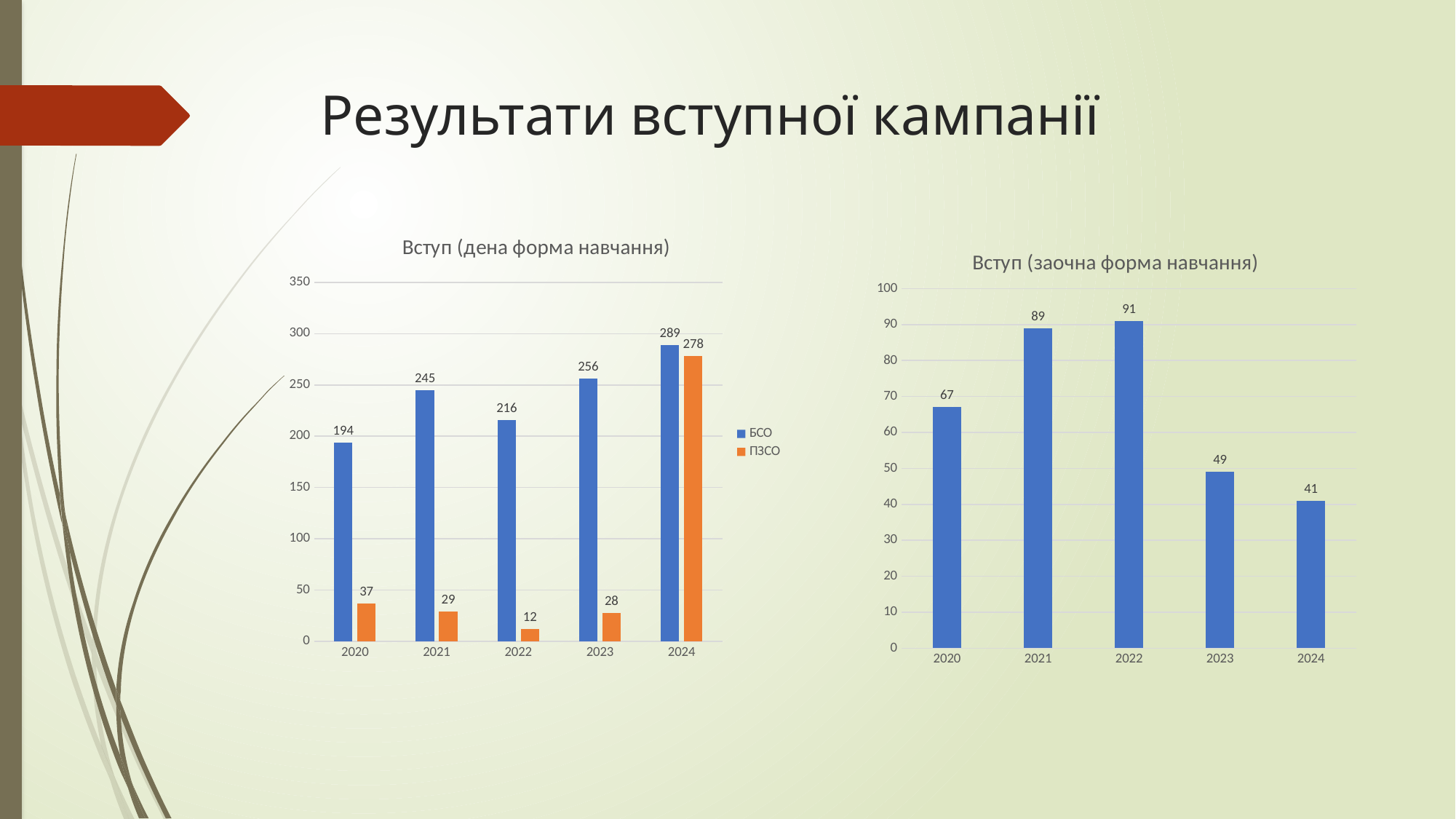
In the chart titled 'Вступ (заочна форма навчання)', what is the value for 2020? 67 In the chart titled 'Вступ (дена форма навчання)', how many series does the legend list? 2 In the chart titled 'Вступ (дена форма навчання)', which year has the lowest ПЗСО value? 2022 In the chart titled 'Вступ (дена форма навчання)', what is the value for БСО in 2021? 245 In the chart titled 'Вступ (заочна форма навчання)', which year has the highest value? 2022 In the chart titled 'Вступ (заочна форма навчання)', how many years are shown on the x axis? 5 In the chart titled 'Вступ (дена форма навчання)', which year has the highest БСО value? 2024 In the chart titled 'Вступ (заочна форма навчання)', which year has the lowest value? 2024 In the chart titled 'Вступ (дена форма навчання)', what is the difference between the БСО and ПЗСО values in 2024? 11 In the chart titled 'Вступ (дена форма навчання)', which series is shown in orange? ПЗСО In the chart titled 'Вступ (дена форма навчання)', what is the value for ПЗСО in 2022? 12 In the chart titled 'Вступ (заочна форма навчання)', what is the difference between the values for 2022 and 2023? 42